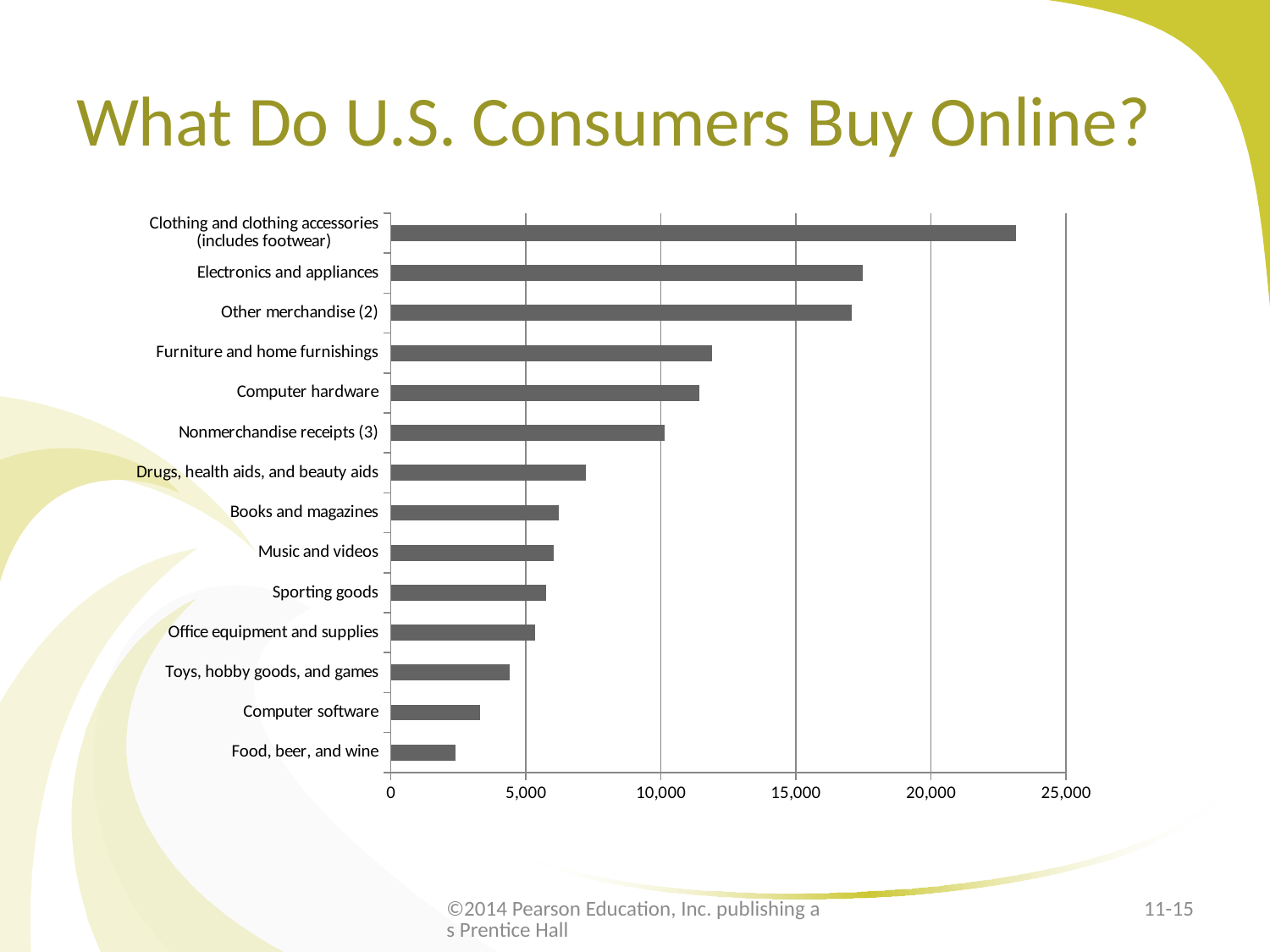
Which category has the highest value? Clothing and clothing accessories (includes footwear) Is the value for Electronics and appliances greater or less than 15,000? greater Is the value for Furniture and home furnishings greater or less than 10,000? greater What is the title of the slide containing the chart? What Do U.S. Consumers Buy Online? How many categories are shown in the chart? 14 Which is larger, the value for Computer software or the value for Toys, hobby goods, and games? Toys, hobby goods, and games What kind of chart is shown on the slide? bar chart Is the value for Food, beer, and wine greater or less than 5,000? less Which category has the lowest value? Food, beer, and wine Which is larger, the value for Drugs, health aids, and beauty aids or the value for Books and magazines? Drugs, health aids, and beauty aids